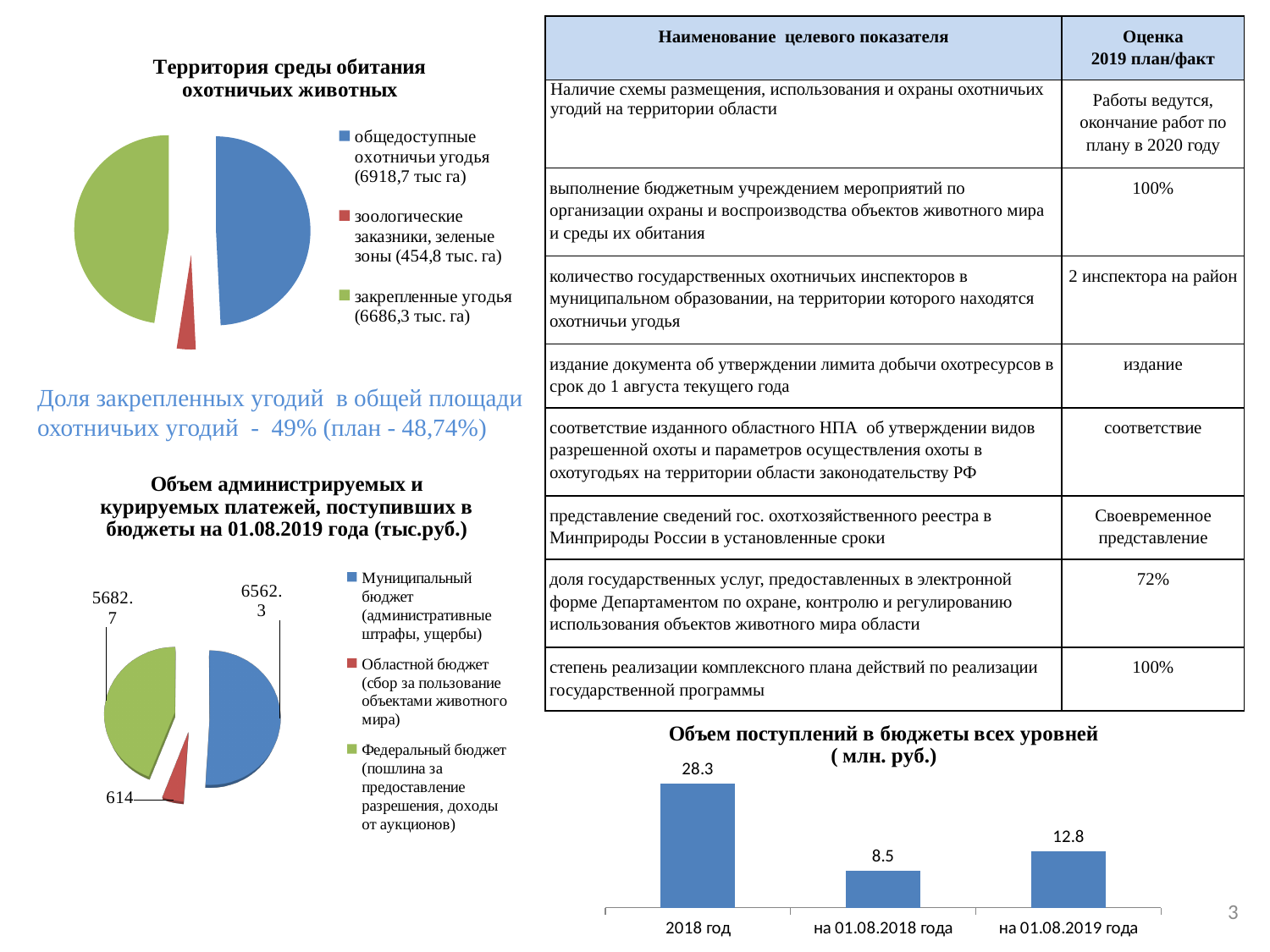
In the pie chart 'Объем администрируемых и курируемых платежей', what is the value for 'Областной бюджет'? 614 In the pie chart 'Объем администрируемых и курируемых платежей', what colour represents 'Федеральный бюджет'? green In the bar chart 'Объем поступлений в бюджеты всех уровней', what is the value for 'на 01.08.2019 года'? 12.8 In the pie chart 'Территория среды обитания охотничьих животных', what is the area of 'зоологические заказники, зеленые зоны'? 454,8 тыс. га In the bar chart 'Объем поступлений в бюджеты всех уровней', what is the value for '2018 год'? 28.3 In the bar chart 'Объем поступлений в бюджеты всех уровней', what is the difference between the values for 'на 01.08.2019 года' and 'на 01.08.2018 года'? 4.3 In the pie chart 'Объем администрируемых и курируемых платежей', which is larger: 'Муниципальный бюджет' or 'Федеральный бюджет'? Муниципальный бюджет What type of chart is 'Объем поступлений в бюджеты всех уровней'? bar chart In the pie chart 'Территория среды обитания охотничьих животных', which category has the largest area? общедоступные охотничьи угодья In the bar chart 'Объем поступлений в бюджеты всех уровней', how many bars are shown? 3 In the pie chart 'Территория среды обитания охотничьих животных', how many categories does the legend list? 3 In the bar chart 'Объем поступлений в бюджеты всех уровней', which category has the lowest value? на 01.08.2018 года